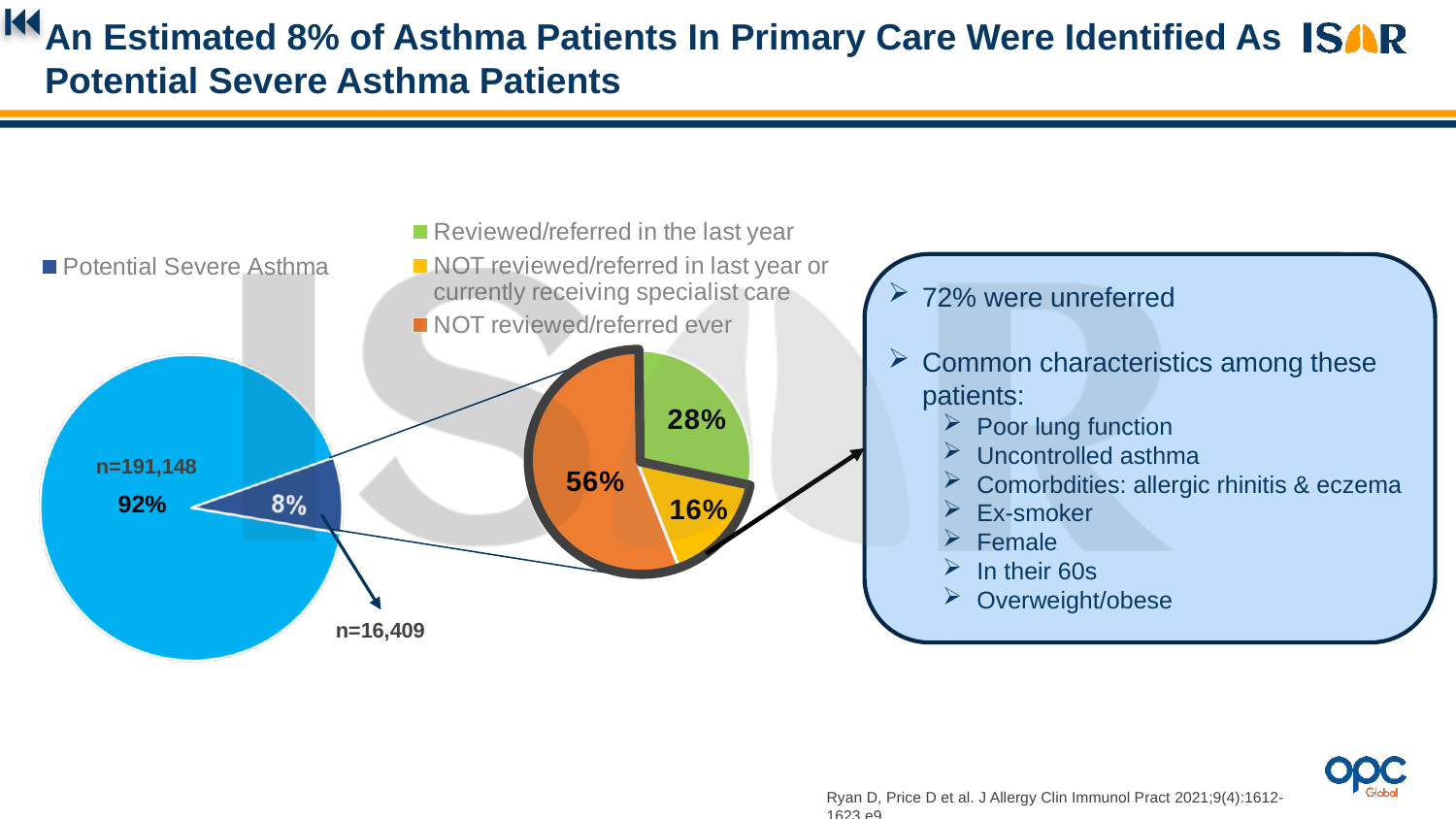
In the right pie chart, what share is labelled for NOT reviewed/referred in last year or currently receiving specialist care? 16% In the left pie chart, what share of patients is labelled Potential Severe Asthma? 8% In the right pie chart, what is the difference between the NOT reviewed/referred ever slice and the Reviewed/referred in the last year slice? 28% What kind of charts are shown on the slide? Pie charts How many entries does the legend of the right pie chart list? 3 In the right pie chart, which category has the smallest slice? NOT reviewed/referred in last year or currently receiving specialist care How many slices does the right pie chart have? 3 In the left pie chart, what is the n value shown for the 8% slice? n=16,409 In the right pie chart, what share is labelled for Reviewed/referred in the last year? 28% In the right pie chart, which category has the largest slice? NOT reviewed/referred ever In the left pie chart, what is the n value shown for the 92% slice? n=191,148